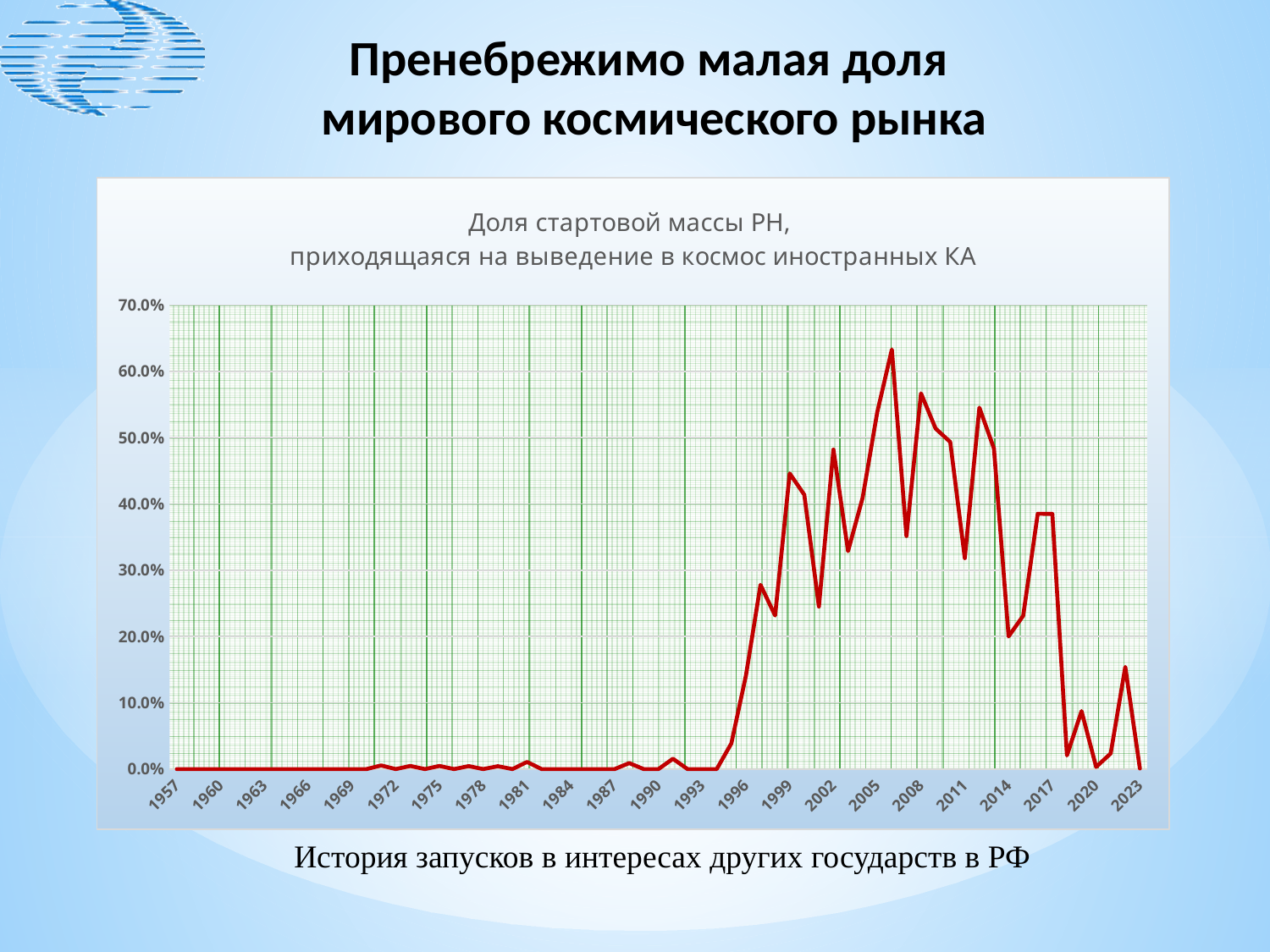
What is the highest value shown on the vertical axis of the chart? 70.0% Is the value for 1996 greater or less than 10%? greater Is the value for 1999 greater or less than 30%? greater Does the line generally rise or fall between 2017 and 2023? fall What is the value for 1957? 0.0% What is the value for 1963? 0.0% What is the title of the chart? Доля стартовой массы РН, приходящаяся на выведение в космос иностранных КА Is the value for 2020 greater or less than 20%? less How many year labels are shown on the horizontal axis? 23 What kind of chart is shown on the slide? line chart